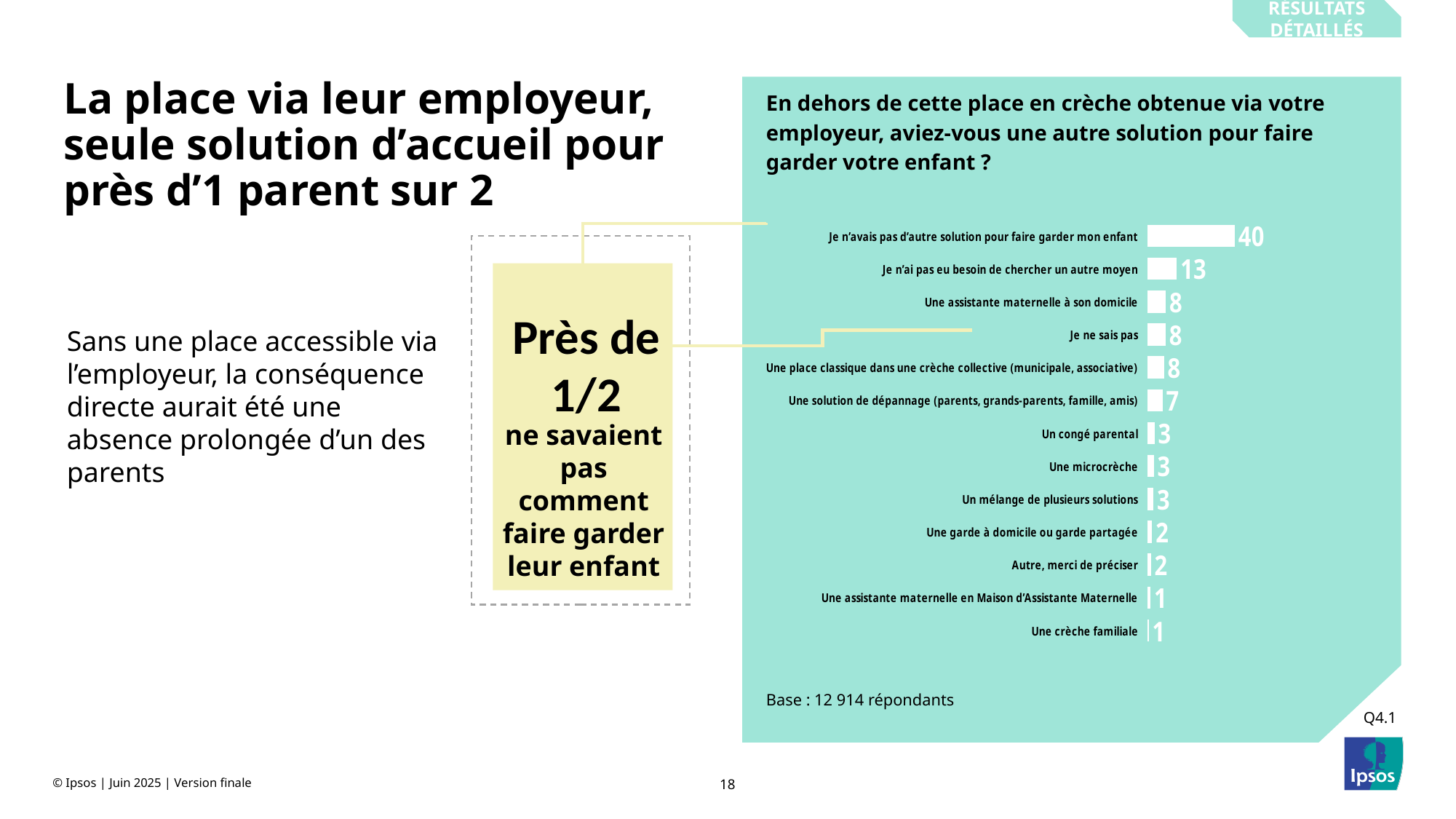
What value is shown for "Je n'avais pas d'autre solution pour faire garder mon enfant"? 40 What value is shown for "Une crèche familiale"? 1 What value is shown for "Je n'ai pas eu besoin de chercher un autre moyen"? 13 What value is shown for "Un congé parental"? 3 What value is shown for "Une solution de dépannage (parents, grands-parents, famille, amis)"? 7 Which is larger: the value for "Je n'ai pas eu besoin de chercher un autre moyen" or the value for "Une solution de dépannage (parents, grands-parents, famille, amis)"? Je n'ai pas eu besoin de chercher un autre moyen What is the difference between the values for "Je n'avais pas d'autre solution pour faire garder mon enfant" and "Je n'ai pas eu besoin de chercher un autre moyen"? 27 Which category has the highest value in the chart? Je n'avais pas d'autre solution pour faire garder mon enfant How many categories are shown in the chart? 13 What question number is indicated in the bottom right corner of the chart panel? Q4.1 What kind of chart is shown on the slide? Bar chart What is the base (number of respondents) stated below the chart? 12 914 répondants